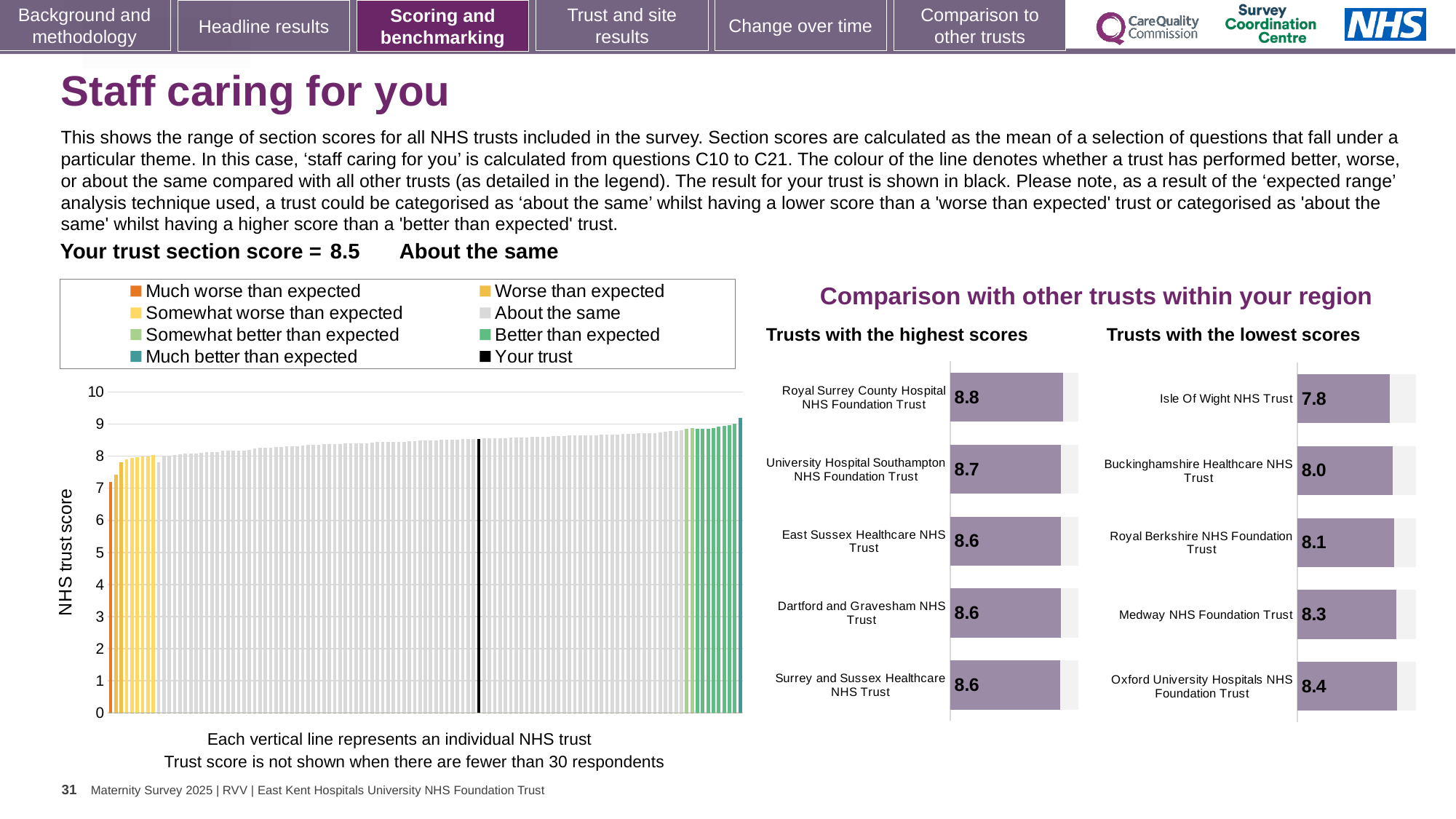
In the 'Trusts with the lowest scores' chart, which has the higher score: Medway NHS Foundation Trust or Royal Berkshire NHS Foundation Trust? Medway NHS Foundation Trust In the 'Trusts with the highest scores' chart, which trust has the highest score? Royal Surrey County Hospital NHS Foundation Trust In the 'Trusts with the lowest scores' chart, what is the score for Medway NHS Foundation Trust? 8.3 In the 'Trusts with the lowest scores' chart, what is the score for Isle Of Wight NHS Trust? 7.8 In the 'Trusts with the lowest scores' chart, which trust has the lowest score? Isle Of Wight NHS Trust What kind of chart is the large chart on the left showing NHS trust scores? Bar chart In the 'Trusts with the lowest scores' chart, what is the difference between the scores of Oxford University Hospitals NHS Foundation Trust and Isle Of Wight NHS Trust? 0.6 How many trusts are shown in the 'Trusts with the highest scores' chart? 5 In the 'Trusts with the highest scores' chart, what is the score for Royal Surrey County Hospital NHS Foundation Trust? 8.8 In the 'Trusts with the highest scores' chart, what is the difference between the scores of Royal Surrey County Hospital NHS Foundation Trust and University Hospital Southampton NHS Foundation Trust? 0.1 How many entries does the legend of the left-hand chart list? 8 In the left-hand chart, is the value for the black 'Your trust' line greater or less than 8? greater